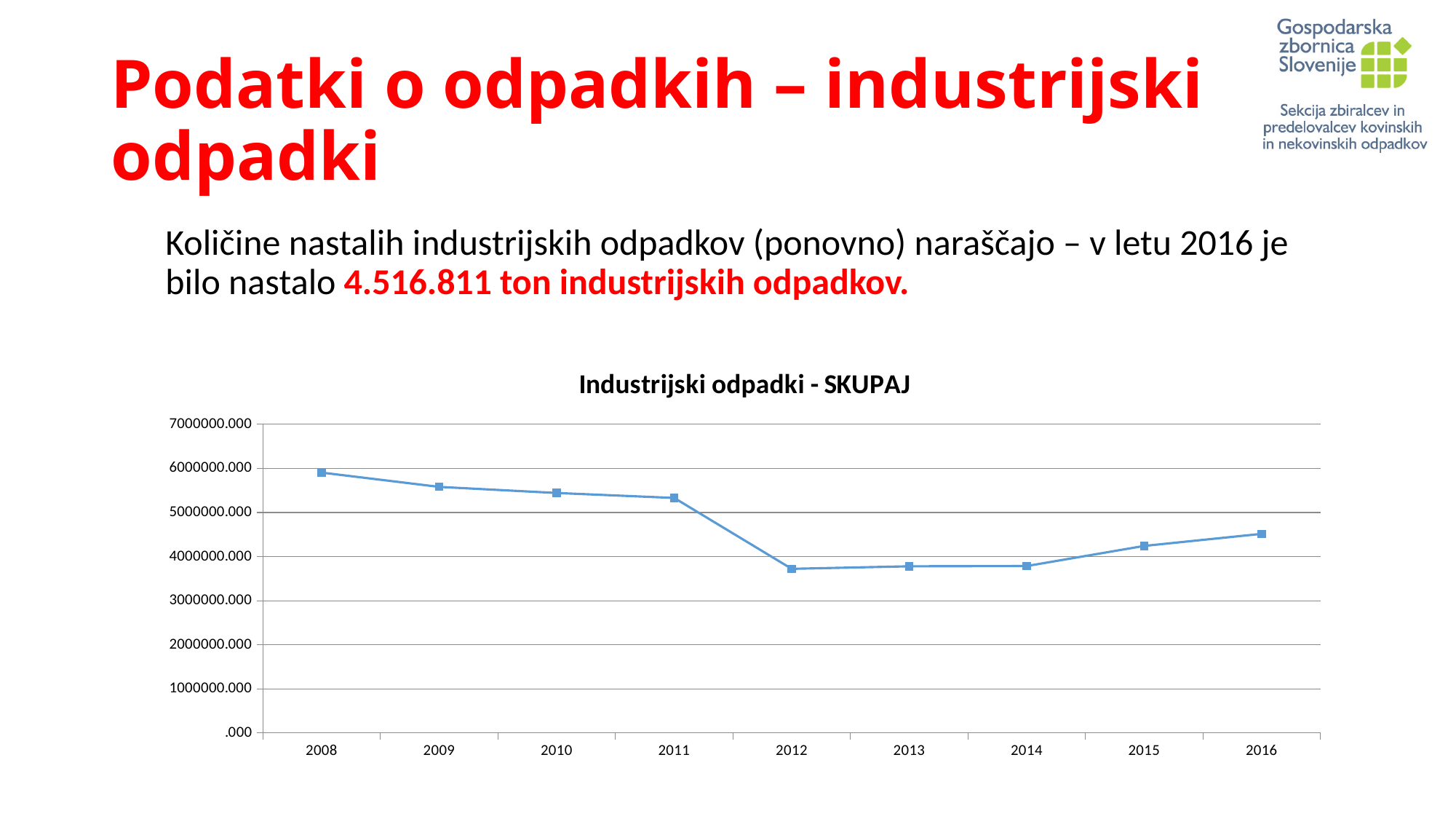
Is the value for 2011 greater or less than 5000000.000? greater Which is larger, the value for 2011 or the value for 2012? 2011 Is the value for 2012 greater or less than 4000000.000? less Which is larger, the value for 2008 or the value for 2016? 2008 Is the value for 2008 greater or less than 5000000.000? greater Which year has the highest value in the chart? 2008 Do the values rise or fall from 2008 to 2011? fall What is the title of the chart? Industrijski odpadki - SKUPAJ How many years are plotted on the x axis of the chart? 9 Do the values rise or fall from 2014 to 2016? rise What kind of chart is shown on the slide? line chart